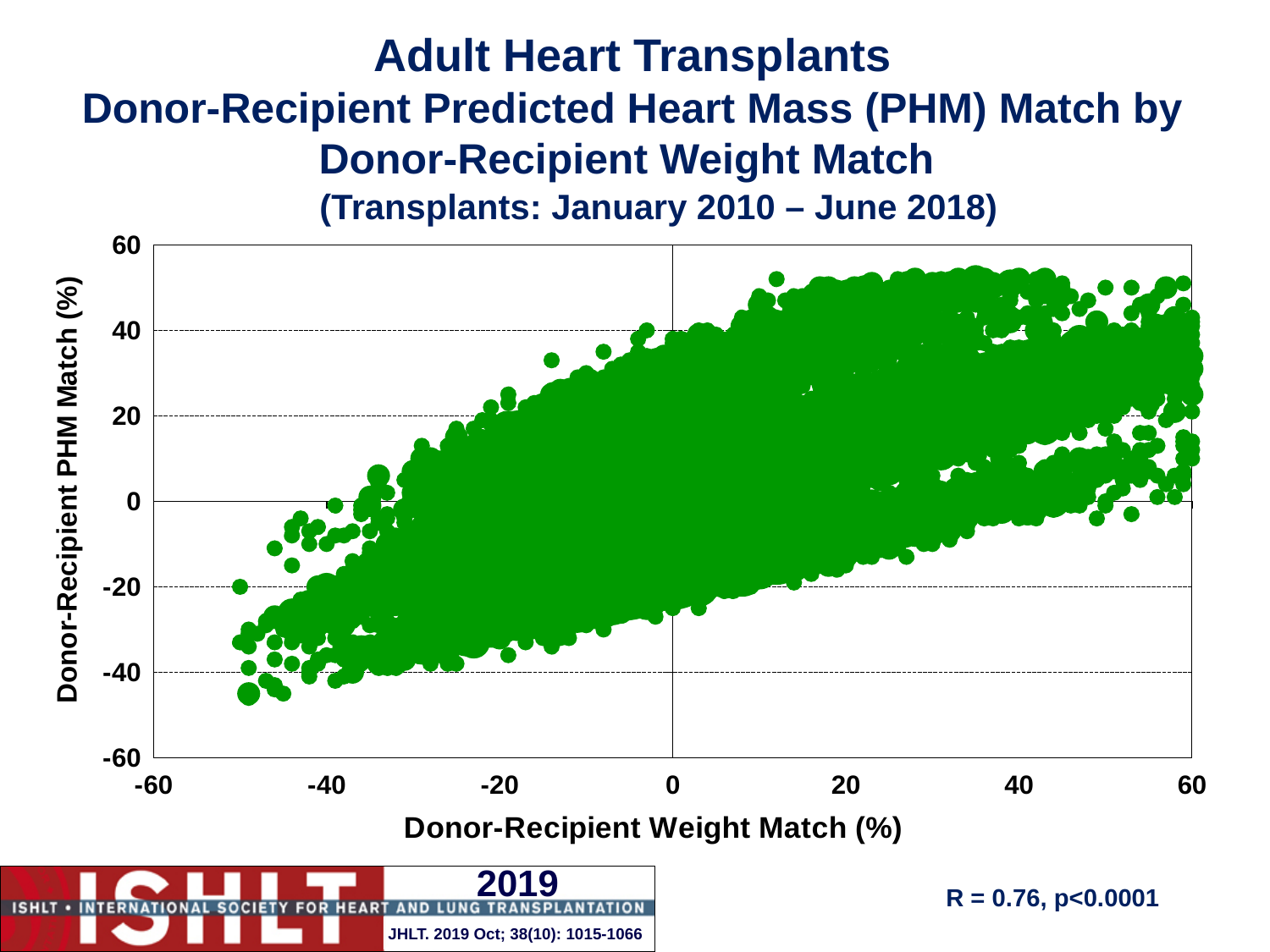
What kind of chart is shown on the slide? Scatter plot What correlation coefficient R is reported on the slide? R = 0.76 What colour are the plotted points? Green As Donor-Recipient Weight Match (%) increases along the x axis, do the Donor-Recipient PHM Match (%) values generally rise or fall? Rise What is the label of the x axis? Donor-Recipient Weight Match (%)